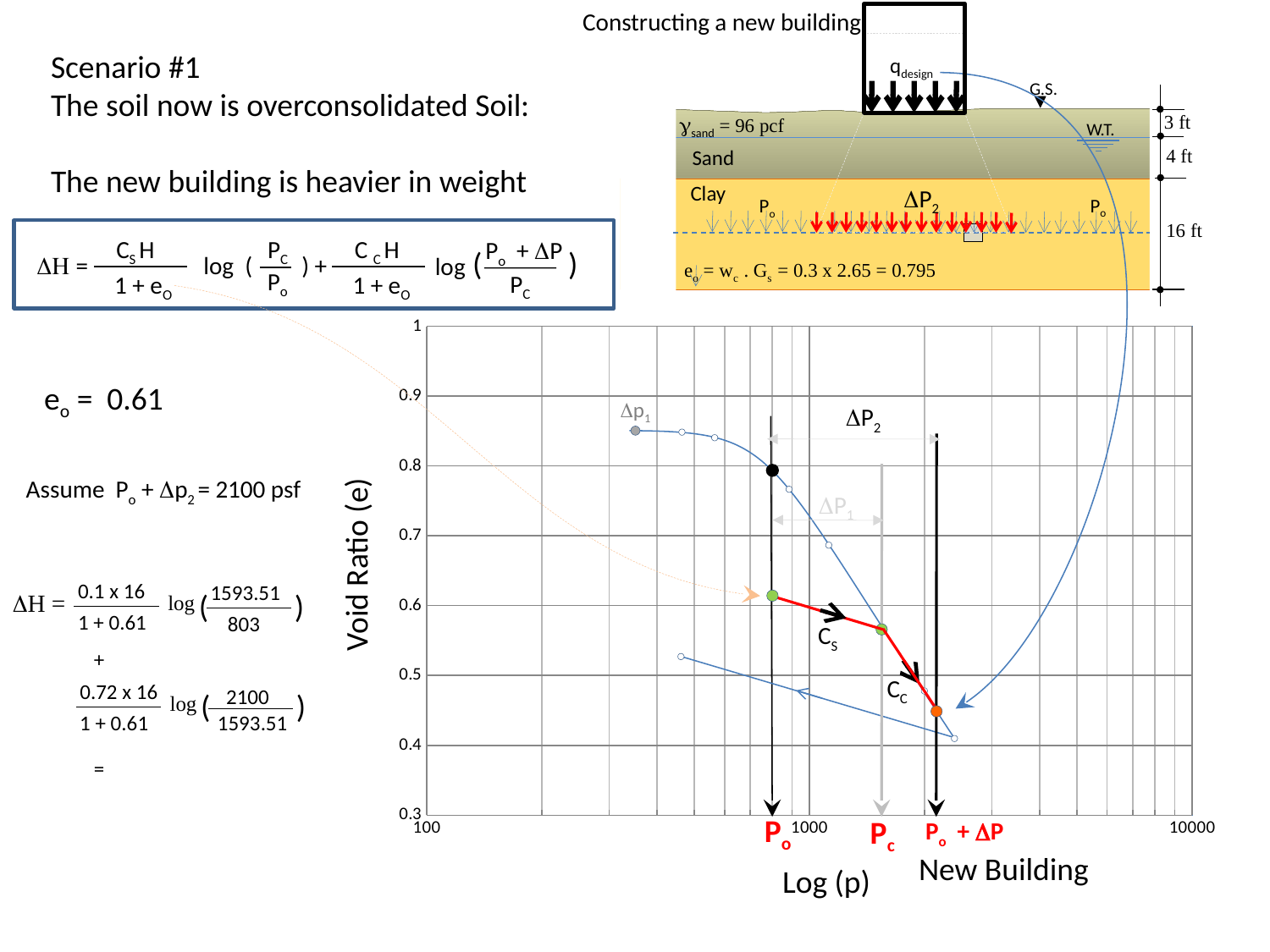
What is the void ratio e_o at P_o on the chart, as stated on the slide? 0.61 What is the highest value shown on the vertical axis of the chart? 1 Which has the larger void ratio on the chart, the point at P_o or the point at P_o + ΔP? P_o Along the red line from P_o to P_o + ΔP, does the void ratio rise or fall as pressure increases? fall Is the void ratio at P_o + ΔP (the orange point) greater or less than 0.5? less Is the void ratio at P_c greater or less than 0.6? less How many labelled pressure positions (P_o, P_c, P_o + ΔP) are marked with vertical arrows on the chart? 3 What pressure value is assumed for P_o + Δp2 on the slide? 2100 psf What kind of chart is shown on the slide? line chart What is the label of the horizontal axis of the chart? Log (p) Is the void ratio at the point labelled Δp1 greater or less than 0.8? greater What is the label of the vertical axis of the chart? Void Ratio (e)